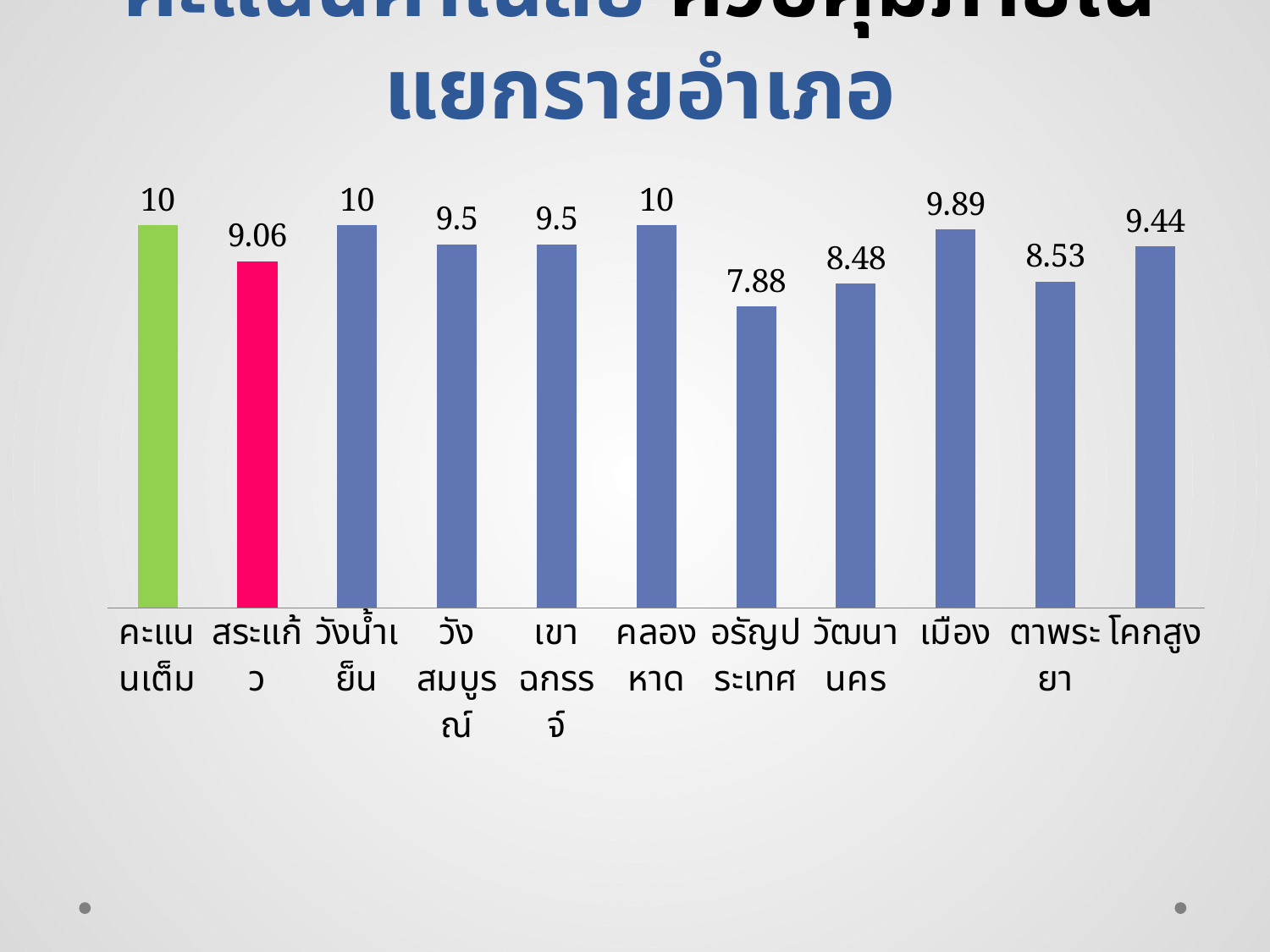
What is the value for สระแก้ว? 9.06 Which is larger, the value for วัฒนานคร or the value for ตาพระยา? ตาพระยา What is the value for เมือง? 9.89 What is the value for โคกสูง? 9.44 Which category has the lowest value? อรัญประเทศ What is the difference between the values for คะแนนเต็ม and สระแก้ว? 0.94 Which bar is coloured pink/red? สระแก้ว How many bars are shown in the chart? 11 Which is larger, the value for โคกสูง or the value for วังสมบูรณ์? วังสมบูรณ์ What kind of chart is shown on the slide? Bar chart What is the difference between the values for เมือง and อรัญประเทศ? 2.01 What is the value for อรัญประเทศ? 7.88